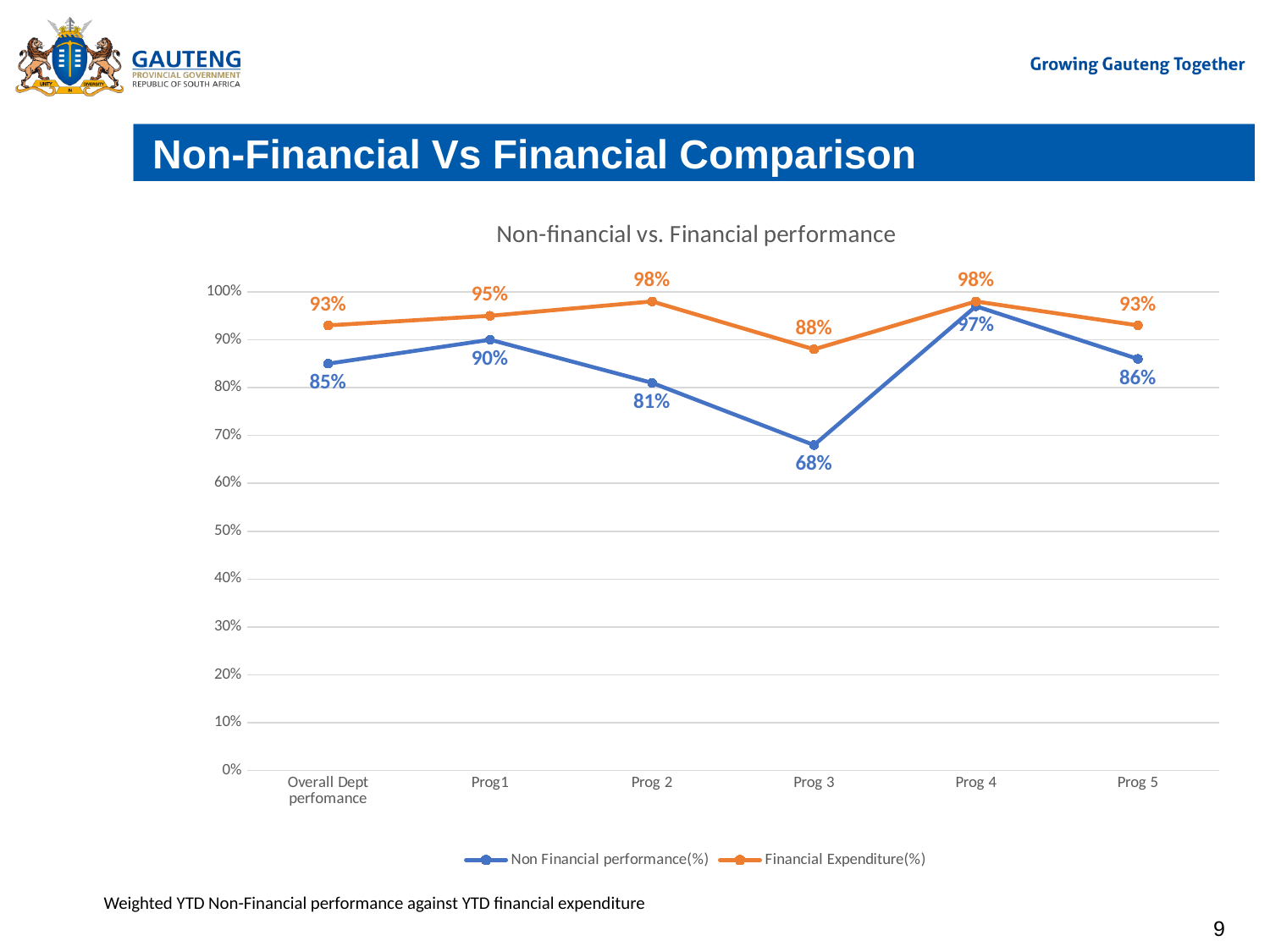
What is the Financial Expenditure(%) value for Prog 5? 93% How many series does the legend list? 2 Is the Non Financial performance(%) value for Prog 2 greater or less than 90%? less What kind of chart is shown on the slide? line chart What is the Non Financial performance(%) value for Prog 3? 68% Which category has the lowest Non Financial performance(%) value? Prog 3 Which is larger for Prog 1: Non Financial performance(%) or Financial Expenditure(%)? Financial Expenditure(%) What is the Financial Expenditure(%) value for Prog 2? 98% How many categories are shown on the x axis? 6 What is the difference between Financial Expenditure(%) and Non Financial performance(%) for Prog 3? 20% Which category has the highest Non Financial performance(%) value? Prog 4 What is the Non Financial performance(%) value for Overall Dept perfomance? 85%